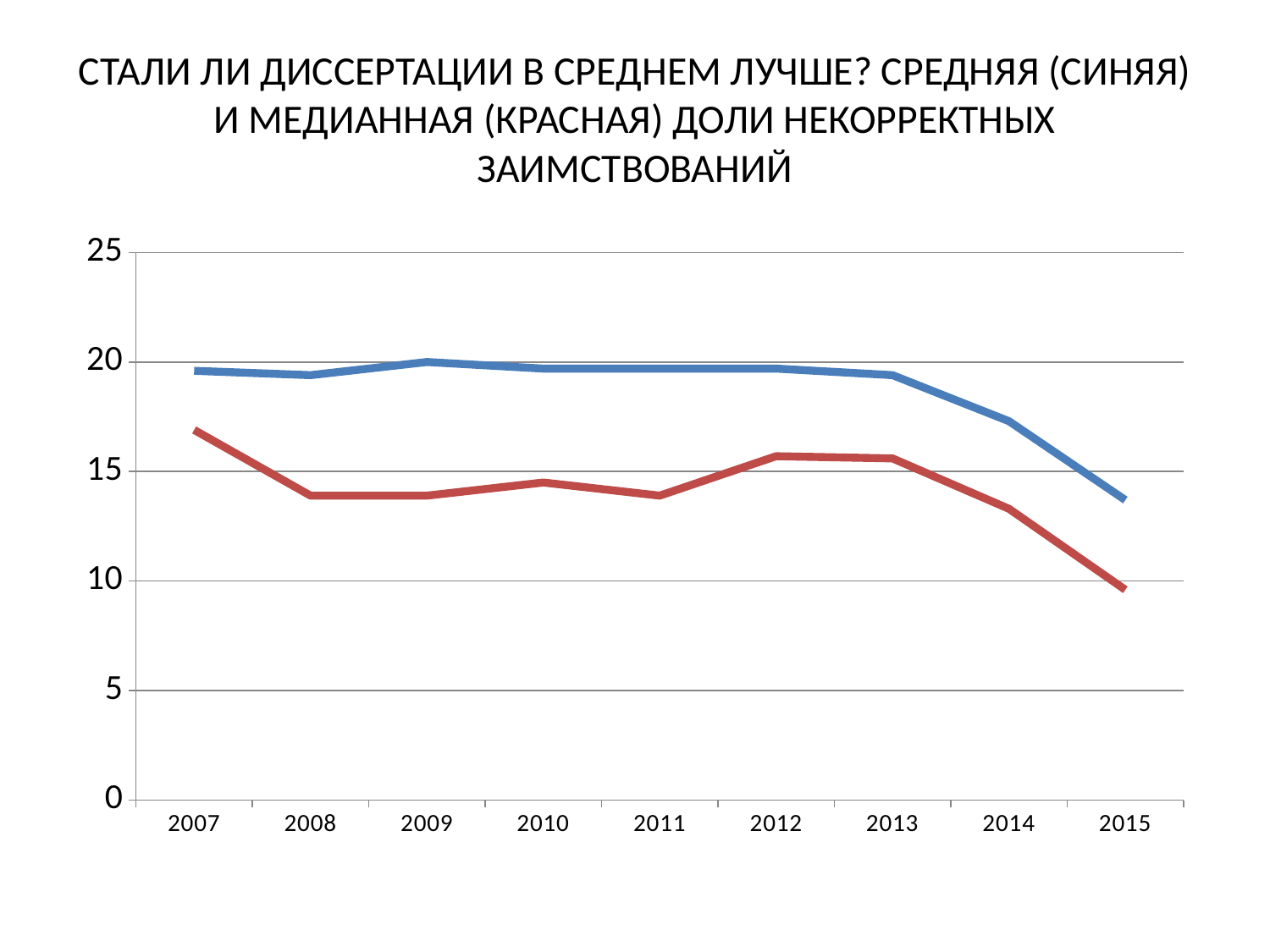
According to the title, which colour represents the median share of incorrect borrowings? red Is the value of the red line in 2008 greater or less than 15? less Is the value of the red line in 2015 greater or less than 10? less In which year is the red (median) line at its highest? 2007 What kind of chart is shown on the slide? line chart In which year is the blue (mean) line at its lowest? 2015 Is the value of the blue line in 2015 greater or less than 15? less How many years are plotted along the x axis? 9 Do the values of the blue line rise or fall from 2013 to 2015? fall In which year is the red (median) line at its lowest? 2015 In 2015, which line has the larger value, the blue or the red? blue